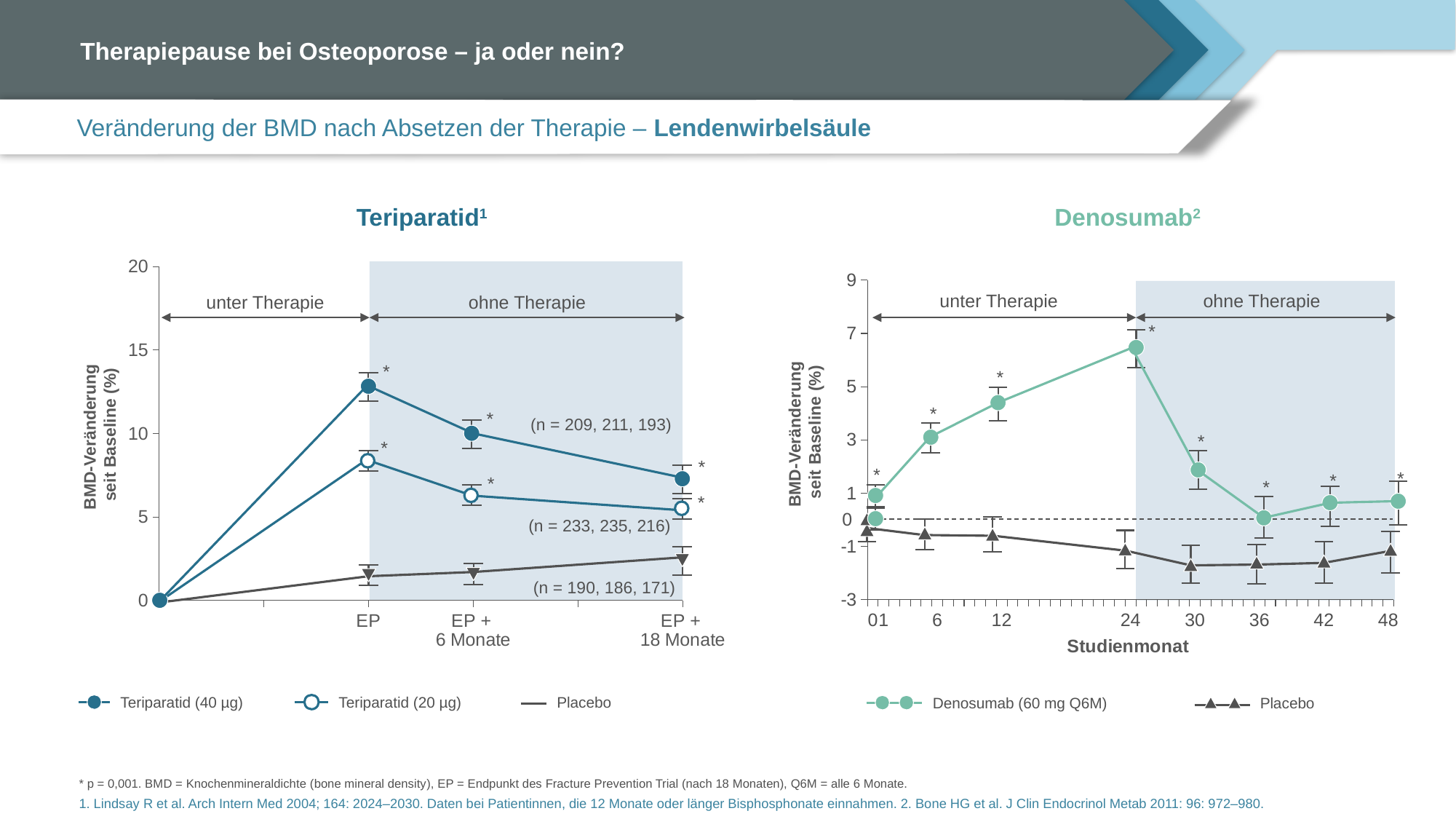
In the Denosumab chart, at which study month does the Denosumab (60 mg Q6M) series reach its highest value? 24 In the Denosumab chart, does the Denosumab (60 mg Q6M) series rise or fall from month 24 to month 36? fall In the Denosumab chart, is the value for Denosumab (60 mg Q6M) at month 24 greater or less than 5? greater In the Denosumab chart, is the value for Placebo at month 30 greater or less than 0? less In the Teriparatid chart, is the value for Teriparatid (40 µg) at EP greater or less than 10? greater In the Denosumab chart, how many series does the legend list? 2 In the Teriparatid chart, at EP, which series has the larger value: Teriparatid (40 µg) or Teriparatid (20 µg)? Teriparatid (40 µg) In the Teriparatid chart, does the Placebo series rise or fall from EP to EP + 18 Monate? rise In the Teriparatid chart, how many series does the legend list? 3 In the Denosumab chart, which phase is marked by the shaded area: unter Therapie or ohne Therapie? ohne Therapie In the Teriparatid chart, what kind of chart is shown? line chart